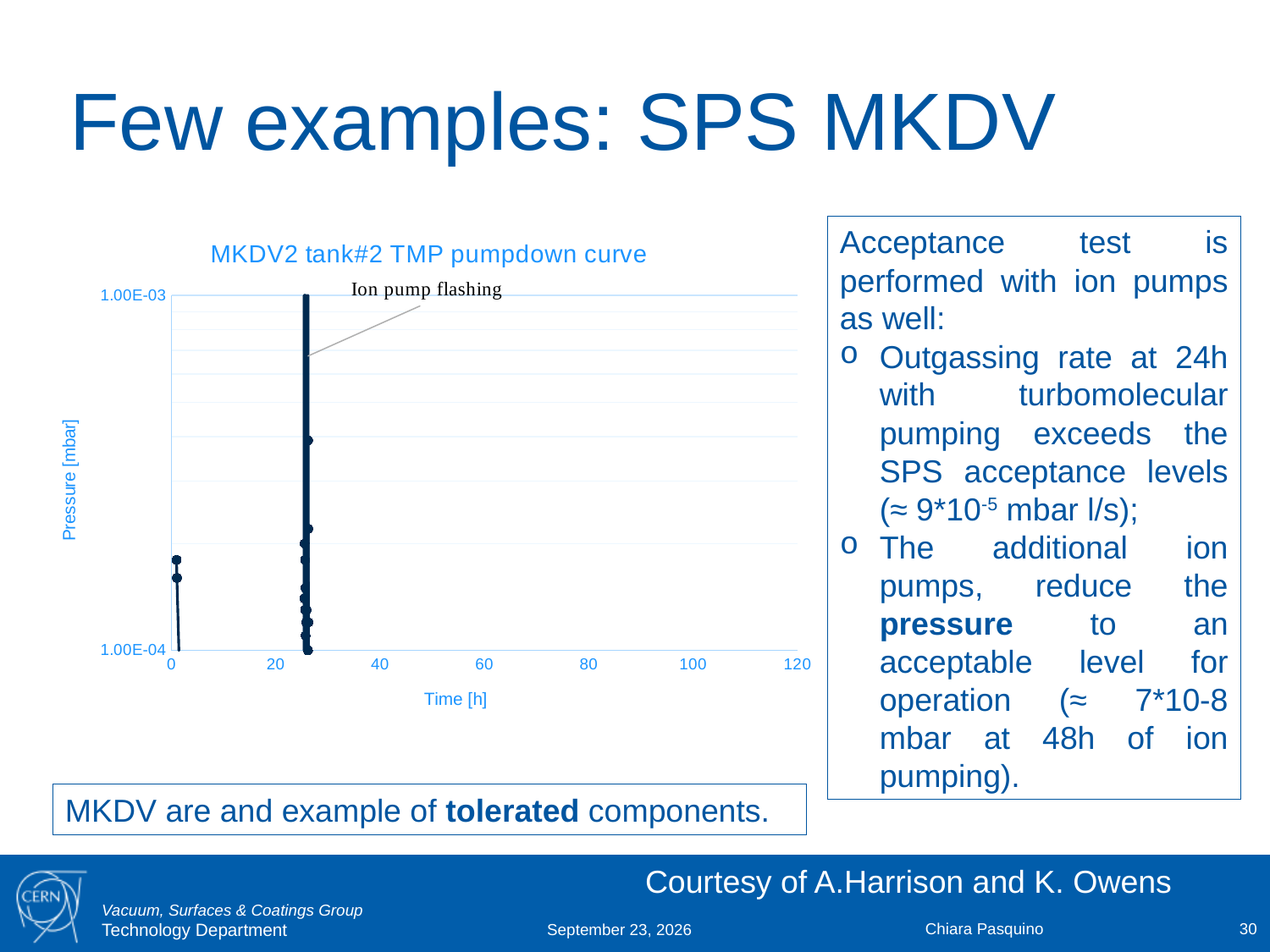
What is the lowest tick value shown on the y axis of the chart? 1.00E-04 What is the label of the x axis of the chart? Time [h] What is the label of the y axis of the chart? Pressure [mbar] Which cluster of points reaches a higher pressure in the chart: the one near 0 h or the one near 26 h? the one near 26 h Is the highest pressure plotted in the chart greater or less than 1.00E-04 mbar? greater What is the highest tick value shown on the y axis of the chart? 1.00E-03 Are the plotted points in the chart located before or after 40 h on the x axis? before What event is annotated on the chart near the tall cluster of points? Ion pump flashing What is the title of the chart on the slide? MKDV2 tank#2 TMP pumpdown curve What is the highest tick value shown on the x axis of the chart? 120 What kind of chart is shown on the slide? scatter chart